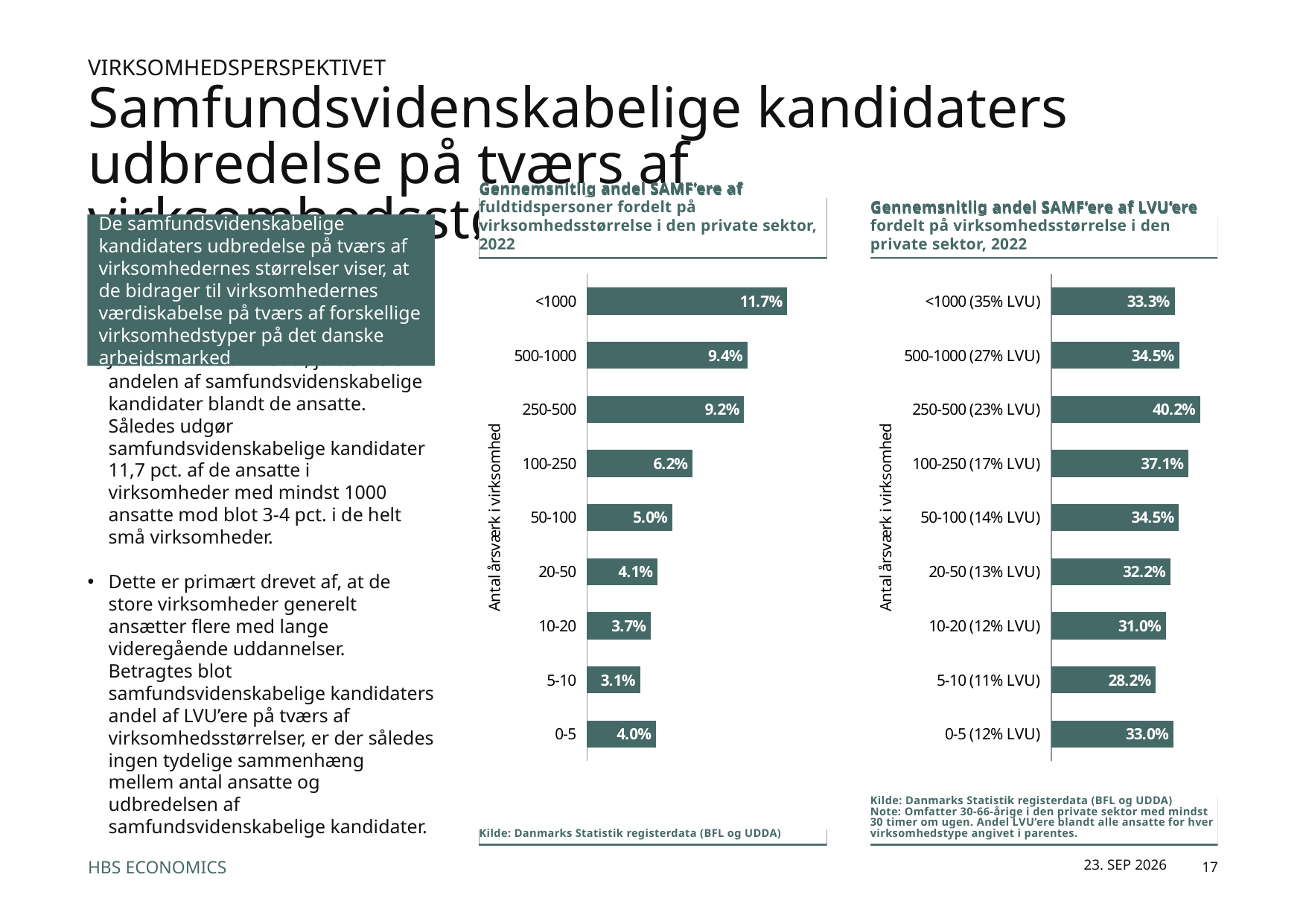
In the left chart (Gennemsnitlig andel SAMF'ere af fuldtidspersoner), what is the value for the 0-5 category? 4.0% In the right chart (Gennemsnitlig andel SAMF'ere af LVU'ere), which category has the highest value? 250-500 (23% LVU) What kind of chart is the left chart (Gennemsnitlig andel SAMF'ere af fuldtidspersoner)? Bar chart In the right chart (Gennemsnitlig andel SAMF'ere af LVU'ere), which is larger: the value for 100-250 (17% LVU) or the value for 20-50 (13% LVU)? 100-250 (17% LVU) In the left chart (Gennemsnitlig andel SAMF'ere af fuldtidspersoner), what is the value for the 500-1000 category? 9.4% In the left chart (Gennemsnitlig andel SAMF'ere af fuldtidspersoner), how many categories are shown? 9 In the left chart (Gennemsnitlig andel SAMF'ere af fuldtidspersoner), what is the difference between the values for <1000 and 100-250? 5.5 percentage points In the right chart (Gennemsnitlig andel SAMF'ere af LVU'ere), what is the difference between the values for 250-500 (23% LVU) and 5-10 (11% LVU)? 12.0 percentage points In the right chart (Gennemsnitlig andel SAMF'ere af LVU'ere), what is the value for the 250-500 (23% LVU) category? 40.2% In the left chart (Gennemsnitlig andel SAMF'ere af fuldtidspersoner), which category has the lowest value? 5-10 In the right chart (Gennemsnitlig andel SAMF'ere af LVU'ere), what is the value for the 5-10 (11% LVU) category? 28.2% In the left chart (Gennemsnitlig andel SAMF'ere af fuldtidspersoner), which category has the highest value? <1000